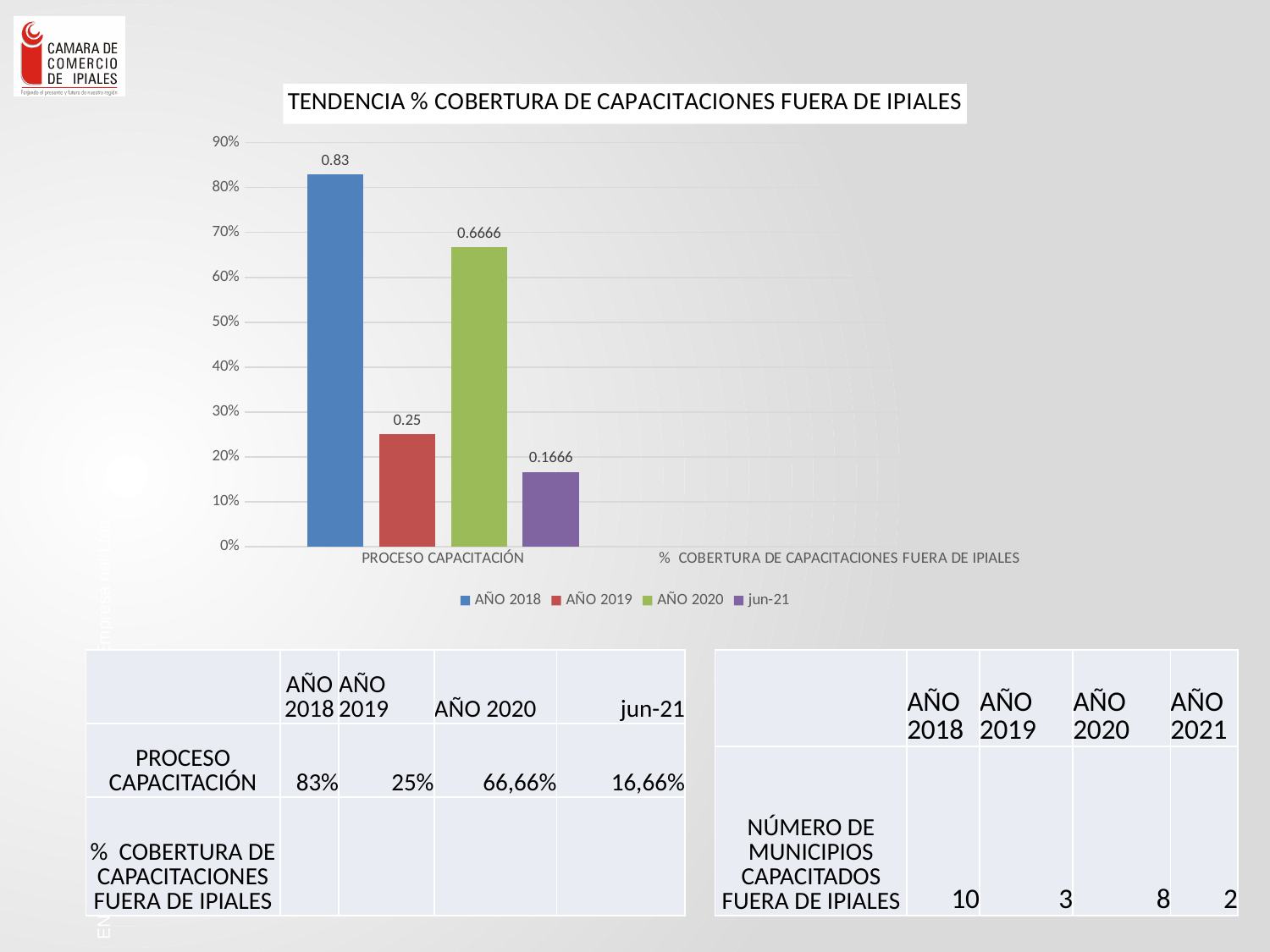
Which is larger for PROCESO CAPACITACIÓN, the AÑO 2020 bar or the AÑO 2019 bar? AÑO 2020 How many series does the legend list? 4 What is the data label on the jun-21 bar for PROCESO CAPACITACIÓN? 0.1666 What is the difference between the AÑO 2018 and AÑO 2019 data labels for PROCESO CAPACITACIÓN? 0.58 What kind of chart is shown on the slide? Bar chart Which series has the highest bar for PROCESO CAPACITACIÓN? AÑO 2018 What is the data label on the AÑO 2018 bar for PROCESO CAPACITACIÓN? 0.83 What is the title of the chart? TENDENCIA % COBERTURA DE CAPACITACIONES FUERA DE IPIALES Is the AÑO 2018 bar for PROCESO CAPACITACIÓN greater or less than 80%? greater What is the data label on the AÑO 2020 bar for PROCESO CAPACITACIÓN? 0.6666 What is the data label on the AÑO 2019 bar for PROCESO CAPACITACIÓN? 0.25 Which series has the lowest bar for PROCESO CAPACITACIÓN? jun-21